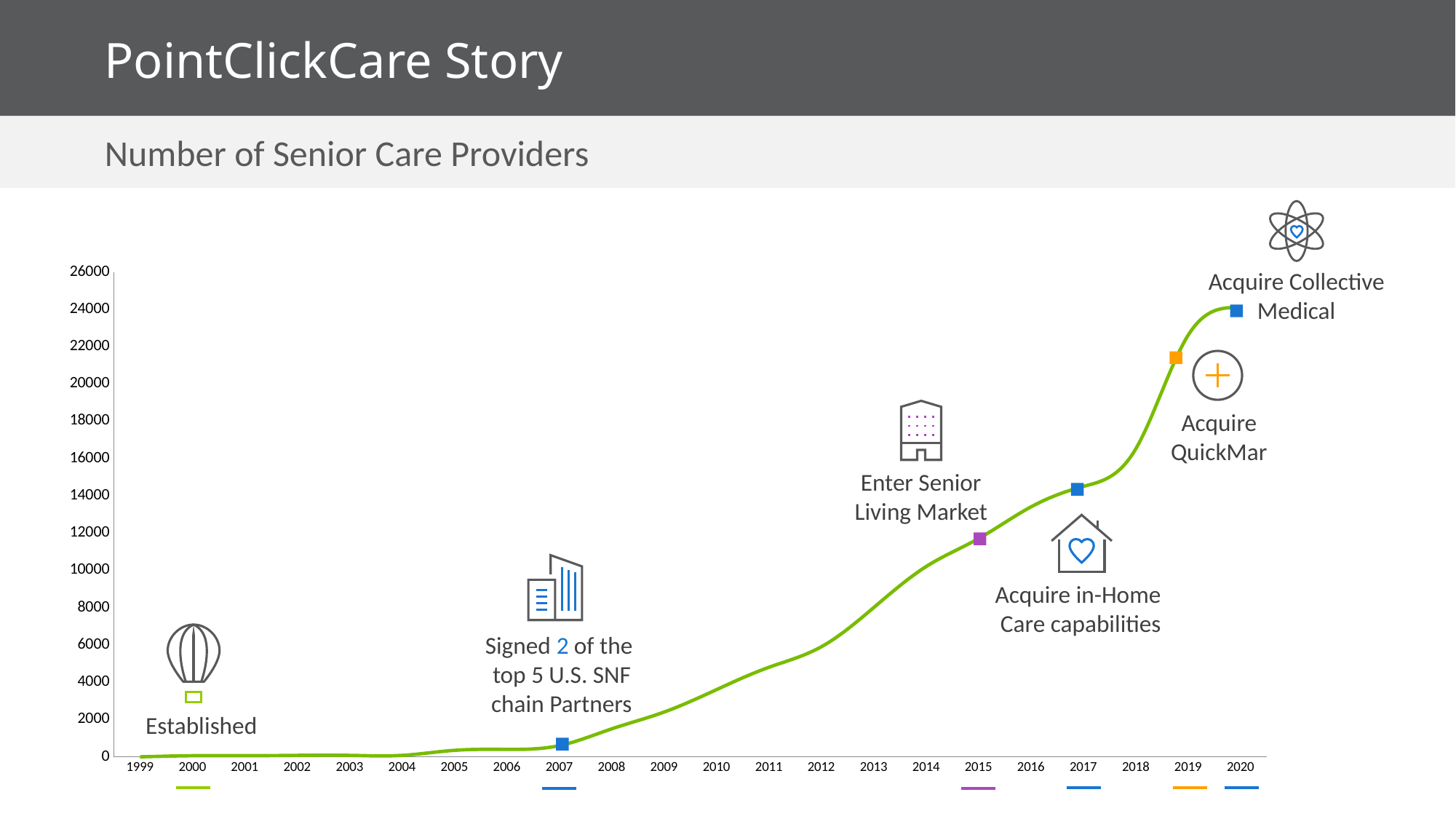
Is the value for 2007 greater or less than 2000? less What kind of chart is shown on the slide? line chart Which year has the highest number of senior care providers? 2020 Is the value for 2012 greater or less than 4000? greater Which milestone is marked on the chart in 2015? Enter Senior Living Market Is the value for 2020 greater or less than 22000? greater How many years are shown on the x axis of the chart? 22 Does the number of senior care providers rise or fall from 1999 to 2020? rise Which year has the larger value, 2015 or 2017? 2017 What is the title of the chart? Number of Senior Care Providers